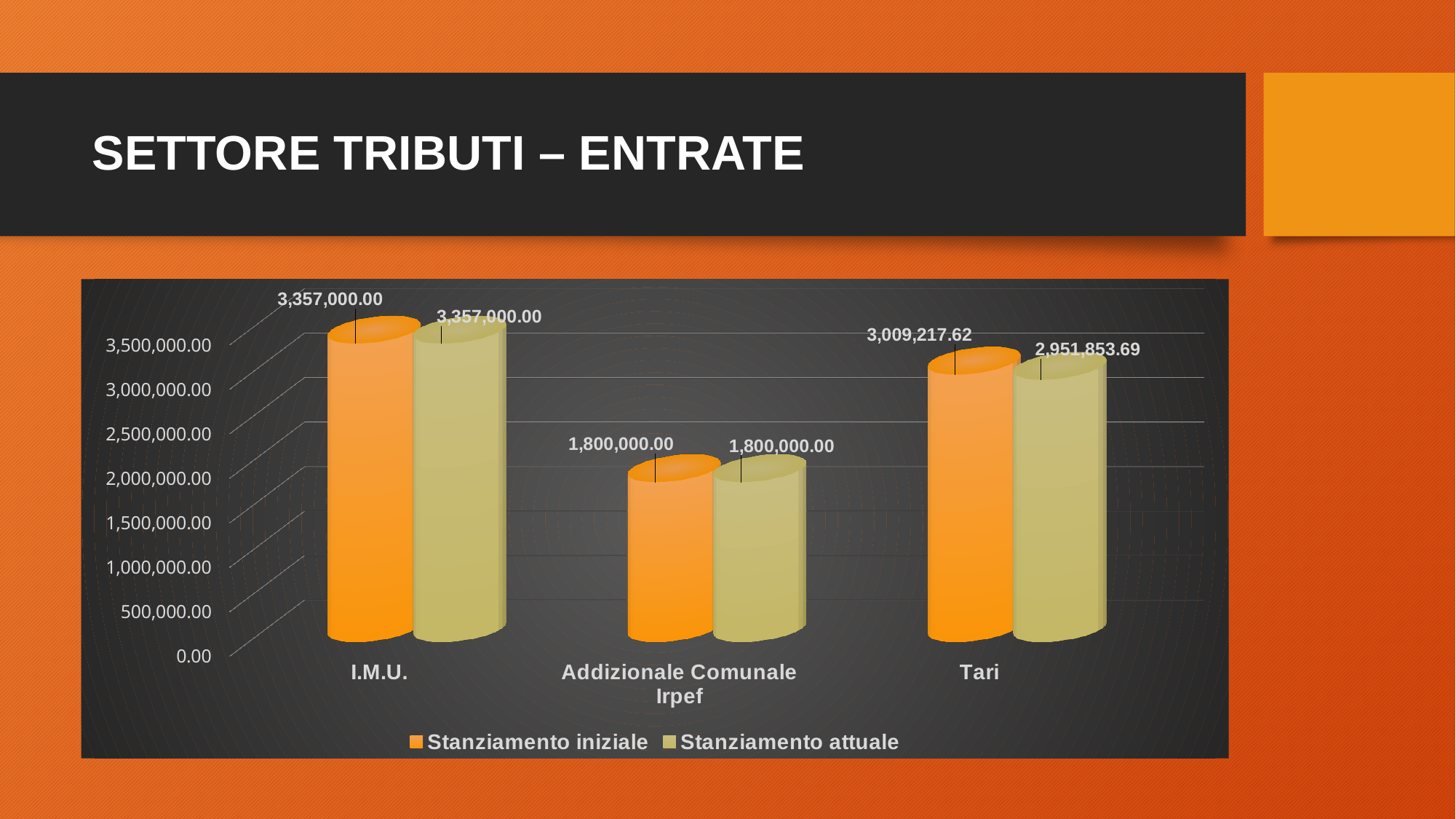
What is the Stanziamento iniziale value for Tari? 3,009,217.62 Which is larger for Tari: Stanziamento iniziale or Stanziamento attuale? Stanziamento iniziale How many series does the chart legend list? 2 What is the Stanziamento attuale value for Tari? 2,951,853.69 Which category has the lowest Stanziamento iniziale value? Addizionale Comunale Irpef What is the difference between the Stanziamento iniziale and Stanziamento attuale values for Tari? 57,363.93 Which category has the highest Stanziamento attuale value? I.M.U. What kind of chart is shown on the slide? Bar chart Is the Stanziamento attuale value for Addizionale Comunale Irpef greater or less than 2,000,000.00? less How many categories are shown on the x axis of the chart? 3 What is the Stanziamento iniziale value for Addizionale Comunale Irpef? 1,800,000.00 What is the Stanziamento iniziale value for I.M.U.? 3,357,000.00